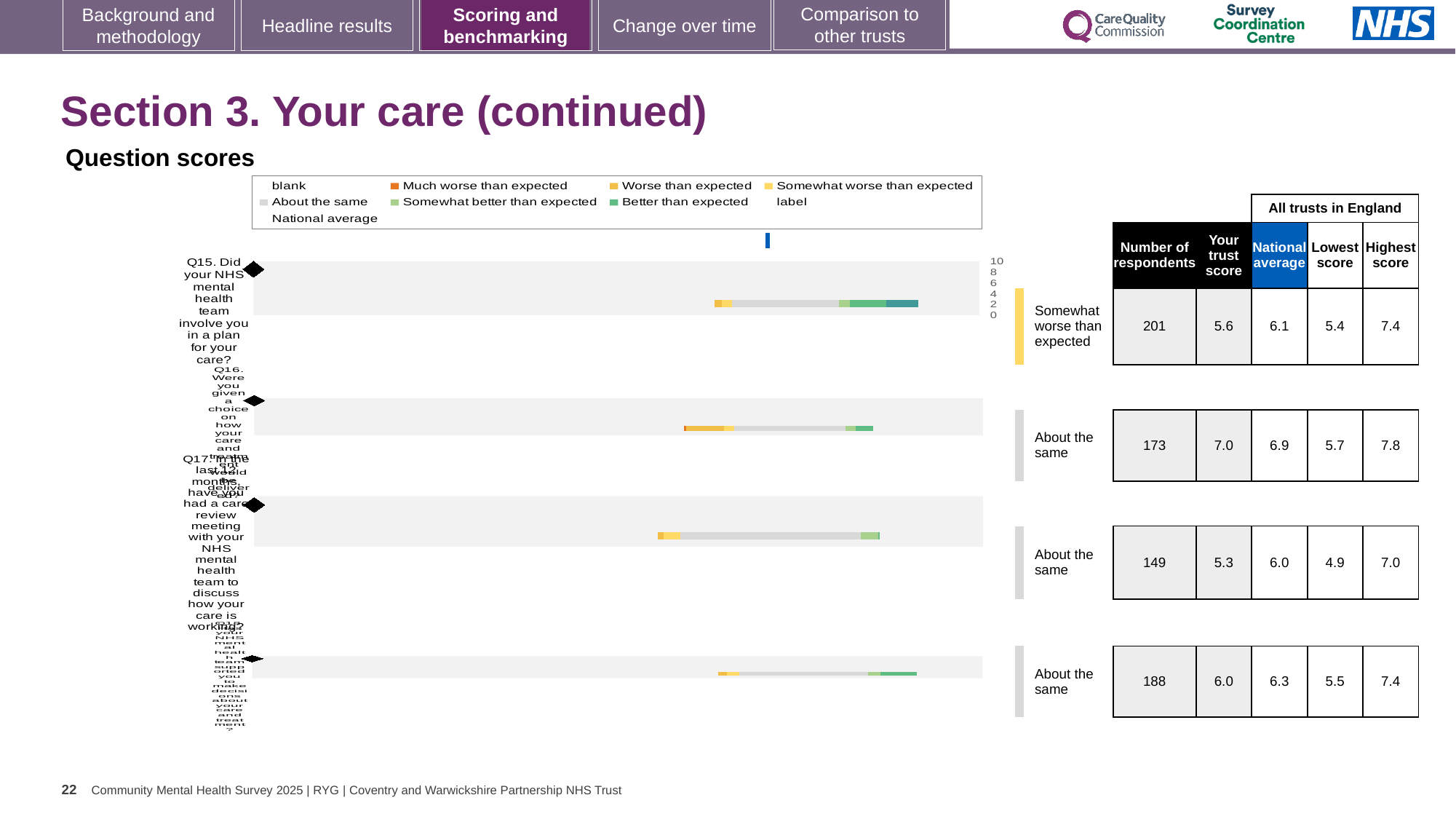
How many question bars are plotted in the question scores chart? 4 What benchmark category is shown for Q15? Somewhat worse than expected In the question scores chart, which legend entry is shown in dark orange? Much worse than expected What is the number of respondents shown for Q16? 173 What is the national average shown for Q17 (care review meeting)? 6.0 Which of the three labelled questions (Q15, Q16, Q17) has the highest 'Your trust score'? Q16 What is the difference between the national average and the trust score for Q17? 0.7 What kind of chart is used to show the question scores on this slide? bar chart Which of the three labelled questions (Q15, Q16, Q17) has the lowest 'Your trust score'? Q17 What is the 'Your trust score' shown for Q15 (Did your NHS mental health team involve you in a plan for your care?)? 5.6 Is the trust score for Q16 larger or smaller than its national average? larger What is the highest score across all trusts in England shown for Q16? 7.8